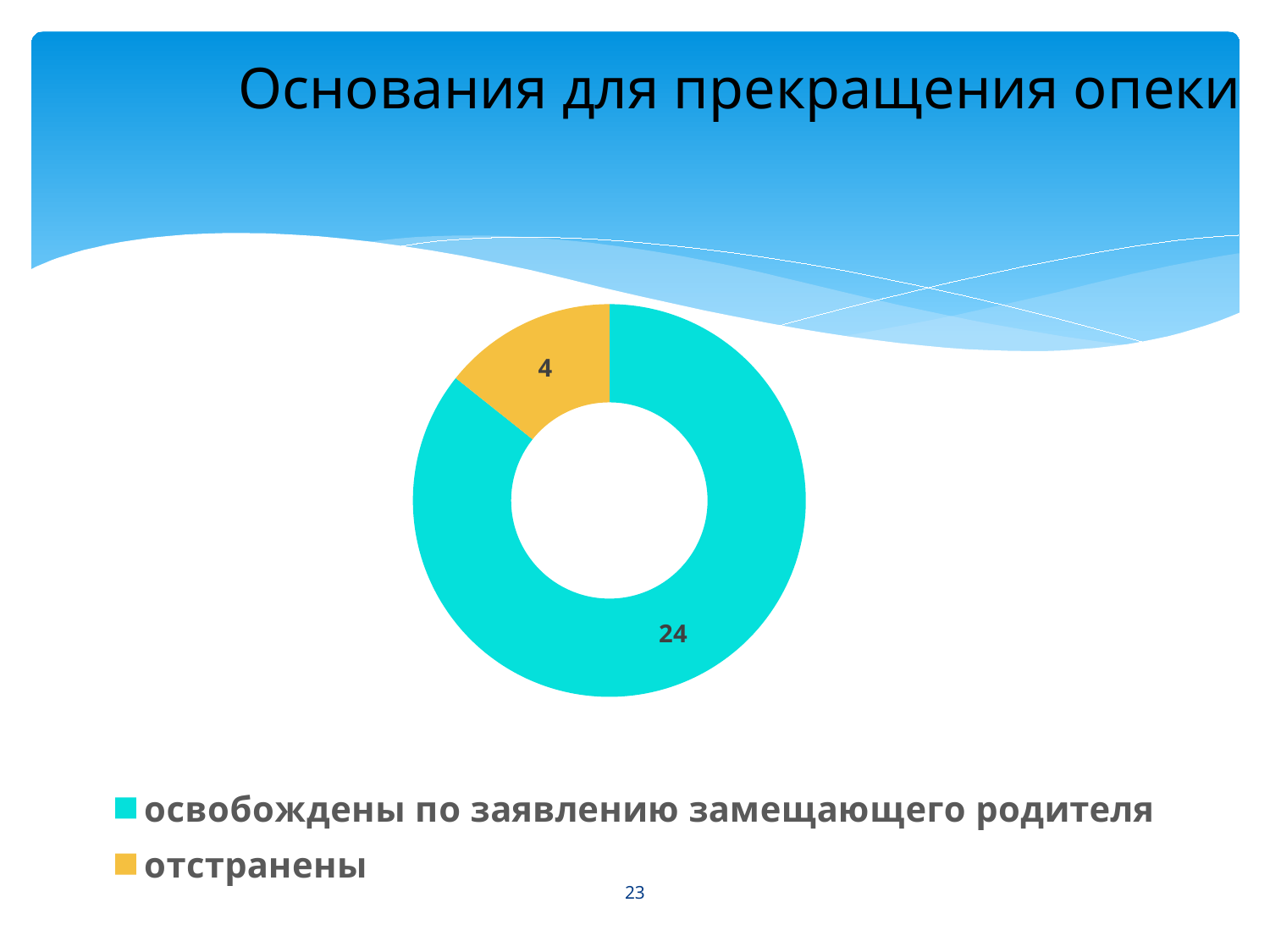
How many categories does the chart show? 2 What colour represents 'отстранены' in the chart? yellow What kind of chart is shown on the slide? doughnut chart What value is shown for the category 'отстранены'? 4 What is the title of the slide? Основания для прекращения опеки What value is shown for the category 'освобождены по заявлению замещающего родителя'? 24 Which is larger: the value for 'отстранены' or the value for 'освобождены по заявлению замещающего родителя'? освобождены по заявлению замещающего родителя Which category has the smallest value? отстранены What is the total of all values shown in the chart? 28 What is the difference between the values for 'освобождены по заявлению замещающего родителя' and 'отстранены'? 20 Which category has the largest value? освобождены по заявлению замещающего родителя